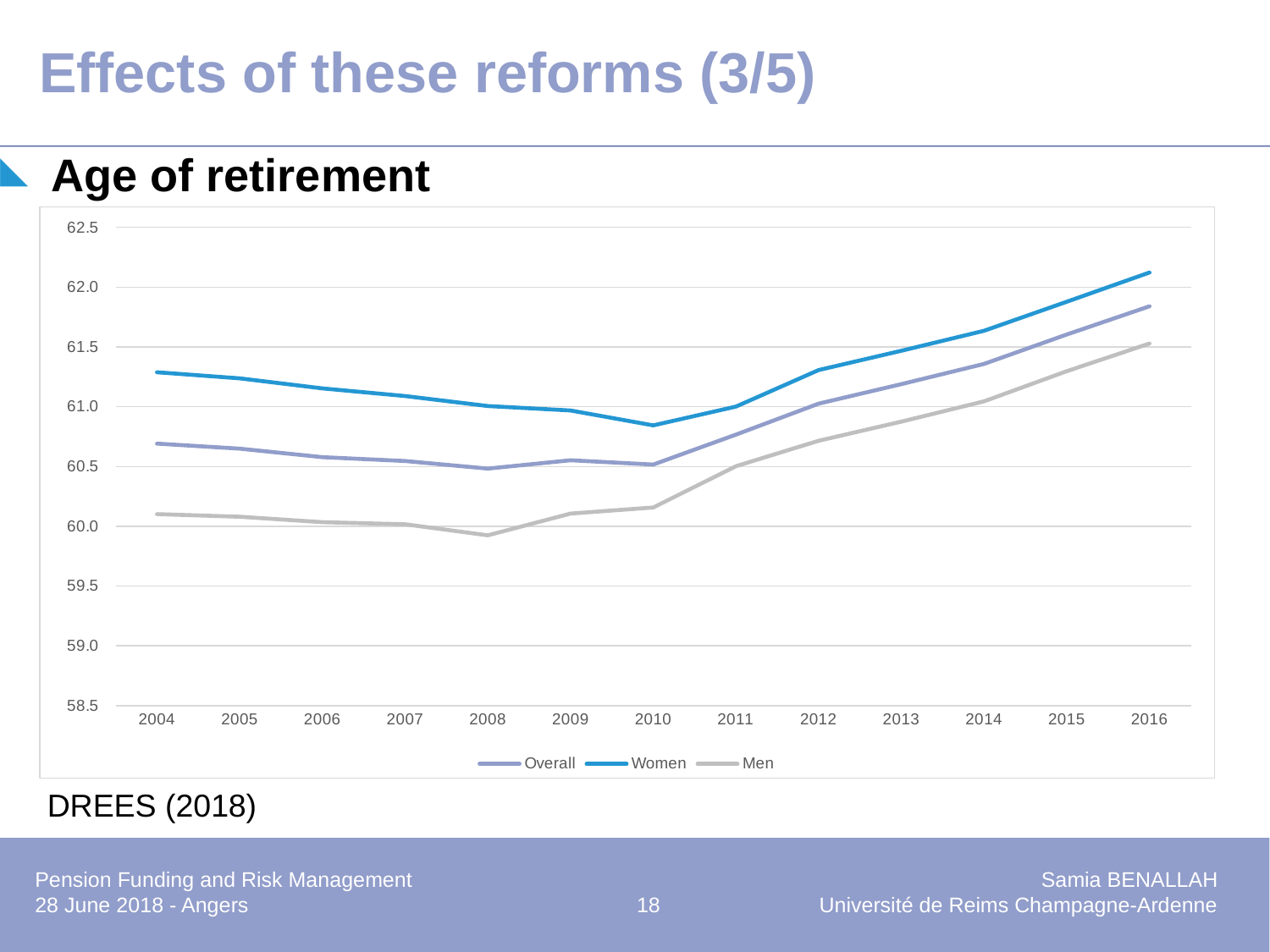
Which series has the highest retirement age in every year shown? Women What kind of chart is shown on the slide? line chart In which year does the Men series reach its lowest value? 2008 In which year does the Women series reach its lowest value? 2010 How many series does the legend list? 3 How many years are plotted along the x axis? 13 Is the value for Women in 2010 greater or less than 61.0? less Which series has the lowest retirement age in every year shown? Men Is the value for Men in 2016 greater or less than 61.0? greater Do the values for all three series rise or fall between 2010 and 2016? rise Is the value for Women in 2004 greater or less than 61.0? greater What are the three entries in the chart legend? Overall, Women, Men